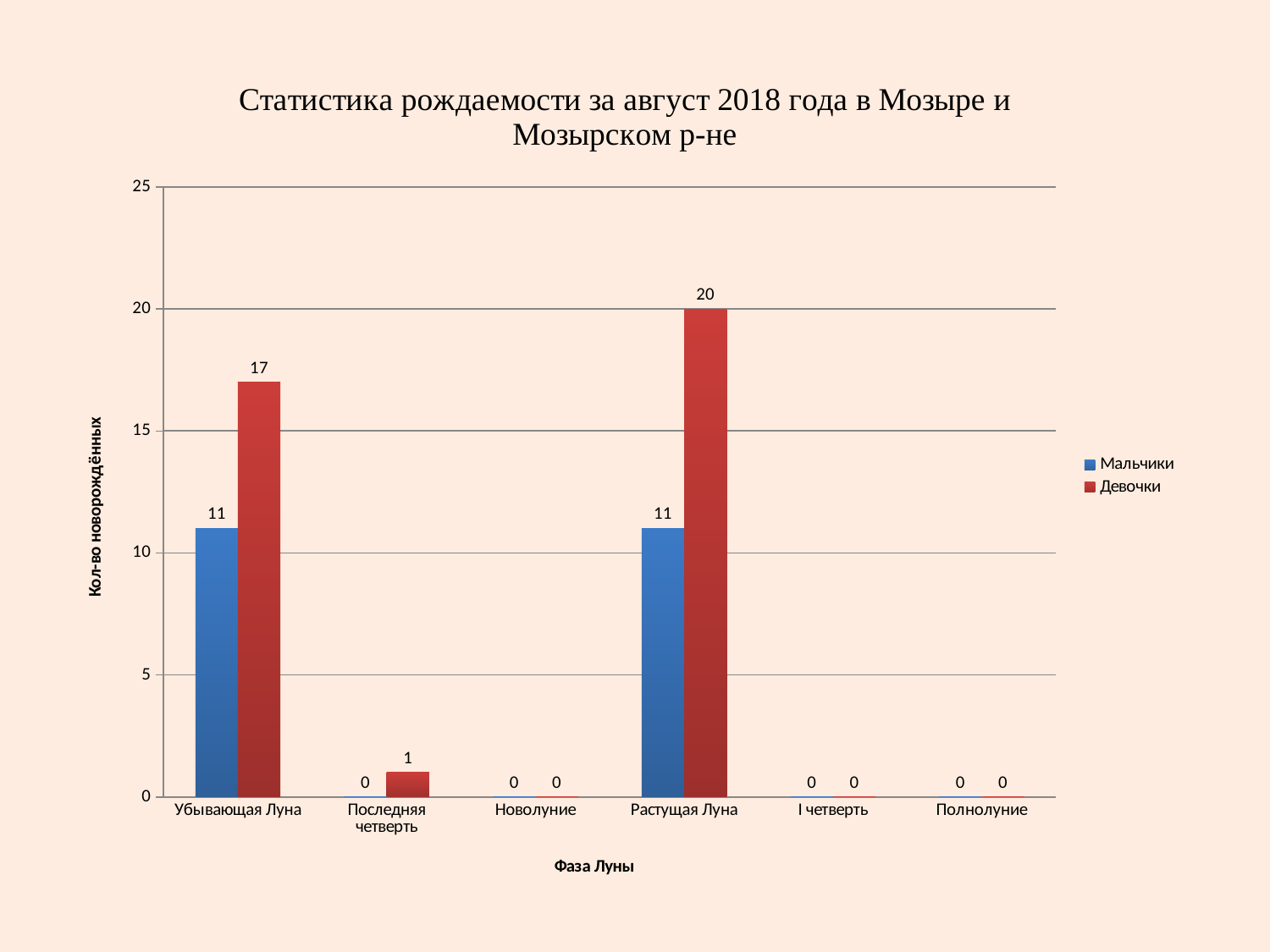
What is the difference between the Девочки values for Растущая Луна and Убывающая Луна? 3 What is the value for Девочки in the Растущая Луна category? 20 How many series does the legend list? 2 What is the value for Мальчики in the Убывающая Луна category? 11 How many categories are shown on the x axis? 6 What is the difference between Девочки and Мальчики in the Растущая Луна category? 9 What kind of chart is shown on the slide? Bar chart Which category has the highest value for Девочки? Растущая Луна Which is larger: Девочки for Убывающая Луна or Мальчики for Убывающая Луна? Девочки for Убывающая Луна What is the value for Девочки in the Последняя четверть category? 1 What is the label of the x axis? Фаза Луны What is the title of the chart? Статистика рождаемости за август 2018 года в Мозыре и Мозырском р-не